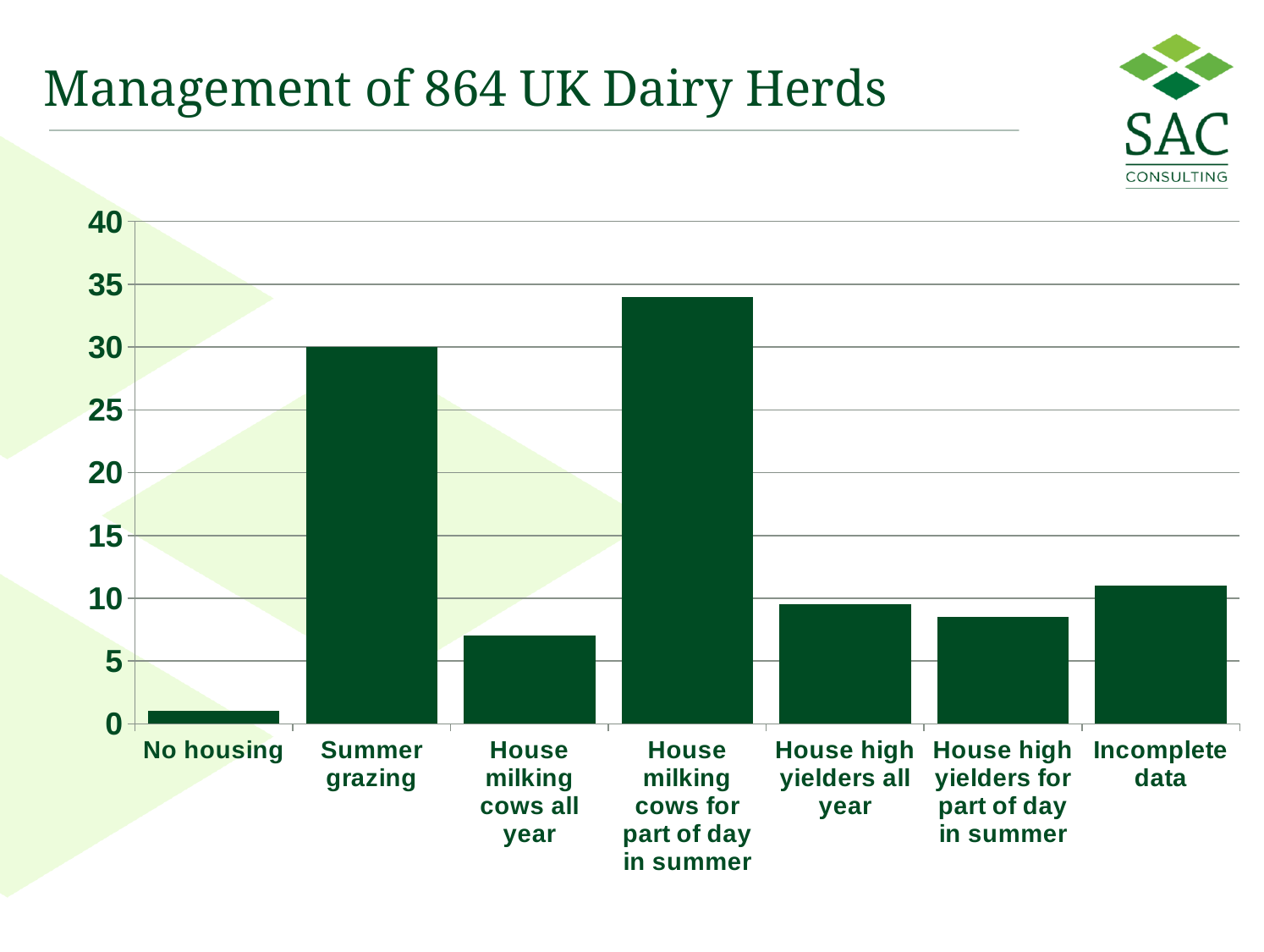
Which category has the lowest bar? No housing Is the value for House high yielders for part of day in summer greater or less than 5? greater What is the value for Summer grazing? 30 Is the value for House milking cows all year greater or less than 10? less How many categories are shown on the x axis of the chart? 7 What is the title of the chart on the slide? Management of 864 UK Dairy Herds Which category has the highest bar? House milking cows for part of day in summer What kind of chart is shown on the slide? Bar chart Is the value for House milking cows for part of day in summer greater or less than 30? greater Which is larger, the value for Summer grazing or the value for House high yielders all year? Summer grazing